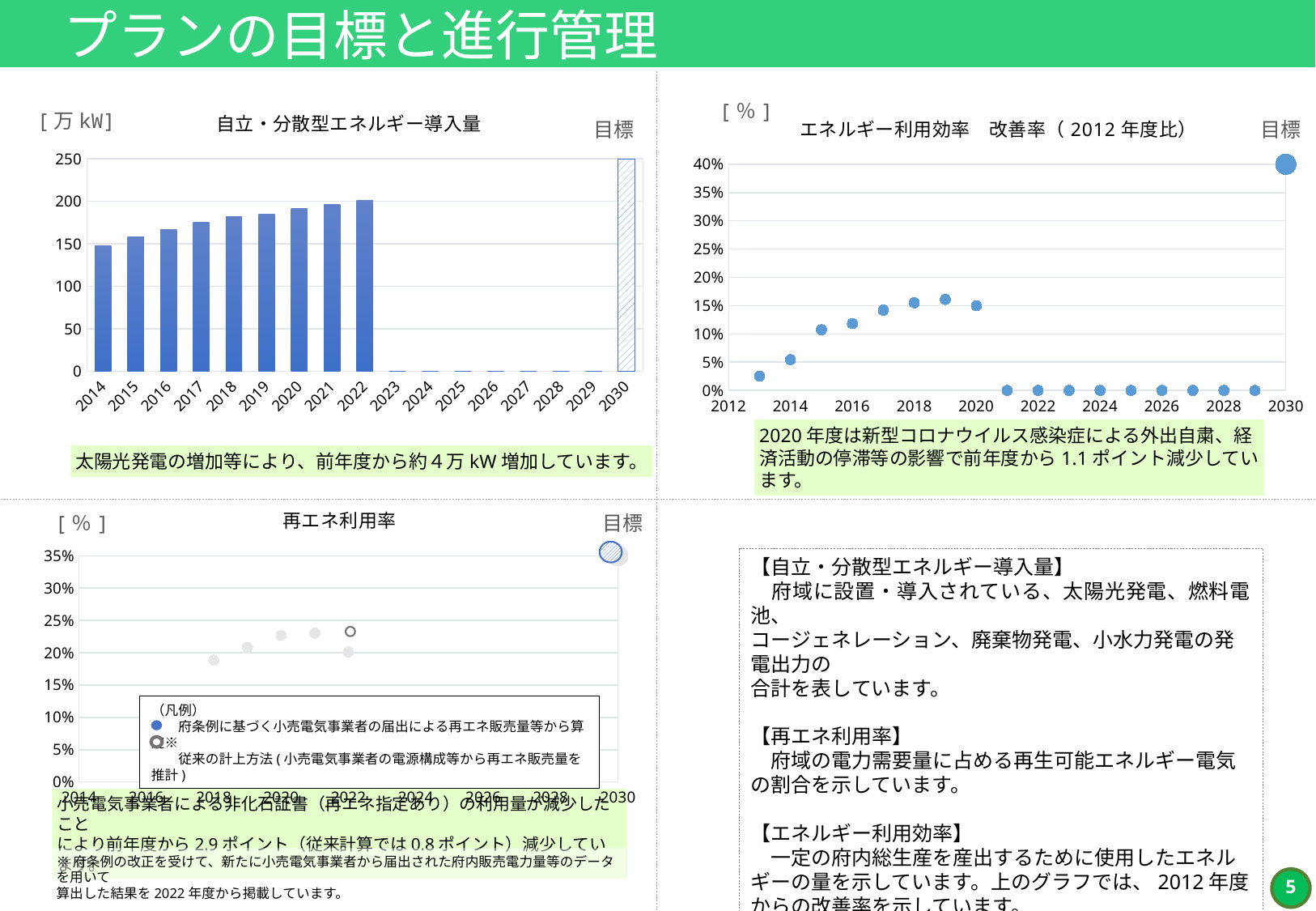
In the 自立・分散型エネルギー導入量 chart, which year from 2014 to 2022 has the highest bar? 2022 In the 自立・分散型エネルギー導入量 chart, what is the 2030 target (目標) value in 万kW? 250 In the エネルギー利用効率 改善率 chart, which year between 2013 and 2020 has the highest plotted value? 2019 In the 自立・分散型エネルギー導入量 chart, do the bars rise or fall from 2014 to 2022? rise In the エネルギー利用効率 改善率 chart, which is larger, the value for 2014 or the value for 2016? 2016 In the 自立・分散型エネルギー導入量 chart, which year from 2014 to 2022 has the lowest bar? 2014 In the 自立・分散型エネルギー導入量 chart, is the value for 2018 greater or less than 150? greater In the 再エネ利用率 chart, what is the 2030 target (目標) value? 35% In the エネルギー利用効率 改善率 chart, is the value for 2013 greater or less than 5%? less How many series does the legend of the 再エネ利用率 chart list? 2 What kind of chart is the 自立・分散型エネルギー導入量 chart? bar chart In the エネルギー利用効率 改善率 chart, what is the 2030 target (目標) value? 40%